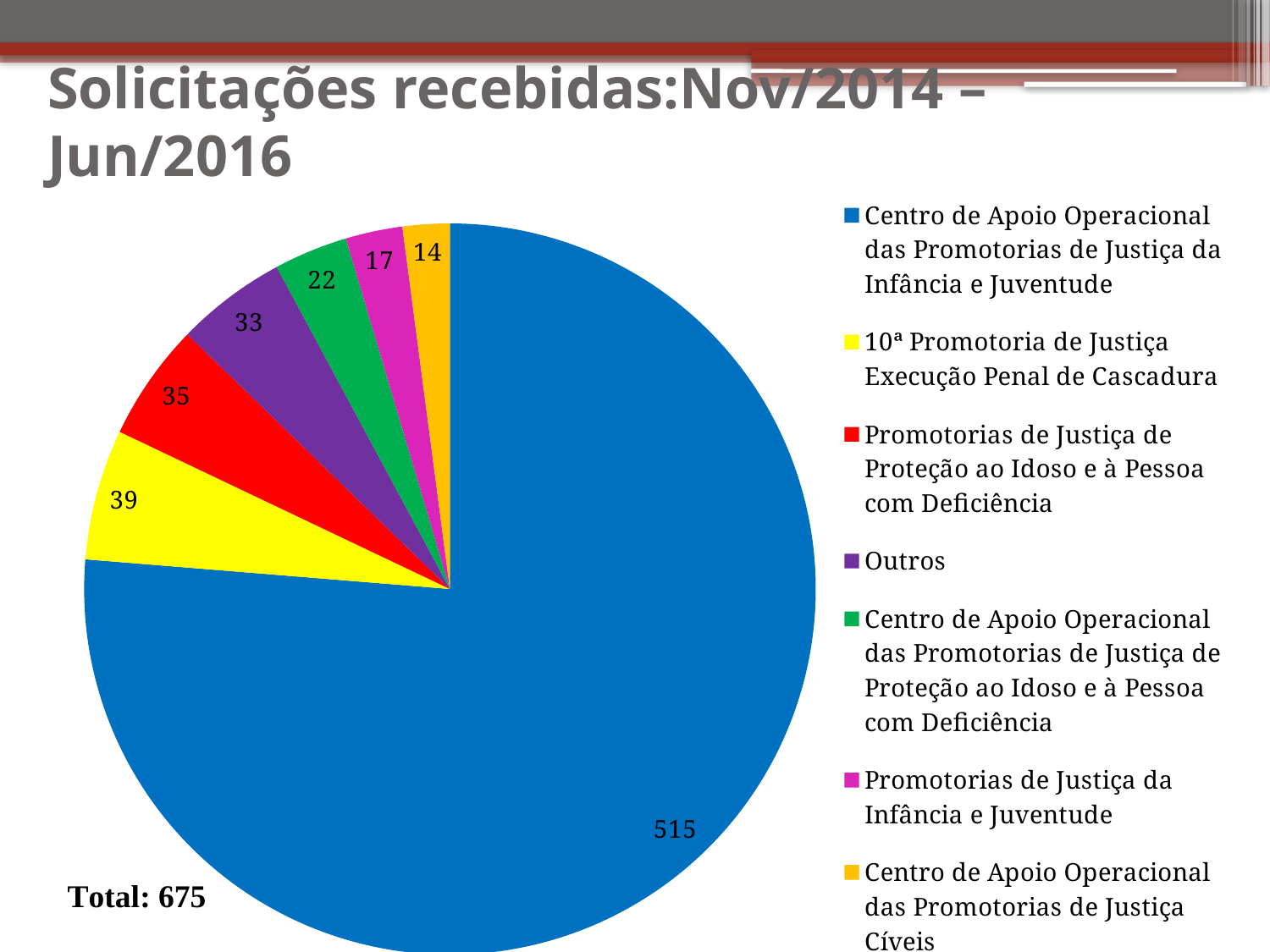
What is the value for Outros? 33 What is the difference between the value for 10ª Promotoria de Justiça Execução Penal de Cascadura and the value for Promotorias de Justiça de Proteção ao Idoso e à Pessoa com Deficiência? 4 What is the value for Centro de Apoio Operacional das Promotorias de Justiça da Infância e Juventude? 515 What kind of chart is shown on the slide? pie chart What is the value for 10ª Promotoria de Justiça Execução Penal de Cascadura? 39 Which category has the largest slice of the pie? Centro de Apoio Operacional das Promotorias de Justiça da Infância e Juventude How many categories does the pie chart have? 7 What colour is the slice for Outros? purple Which is larger: the value for Outros or the value for Promotorias de Justiça da Infância e Juventude? Outros What is the value for Centro de Apoio Operacional das Promotorias de Justiça Cíveis? 14 Which category has the smallest slice of the pie? Centro de Apoio Operacional das Promotorias de Justiça Cíveis What total is printed on the slide for the pie chart? 675